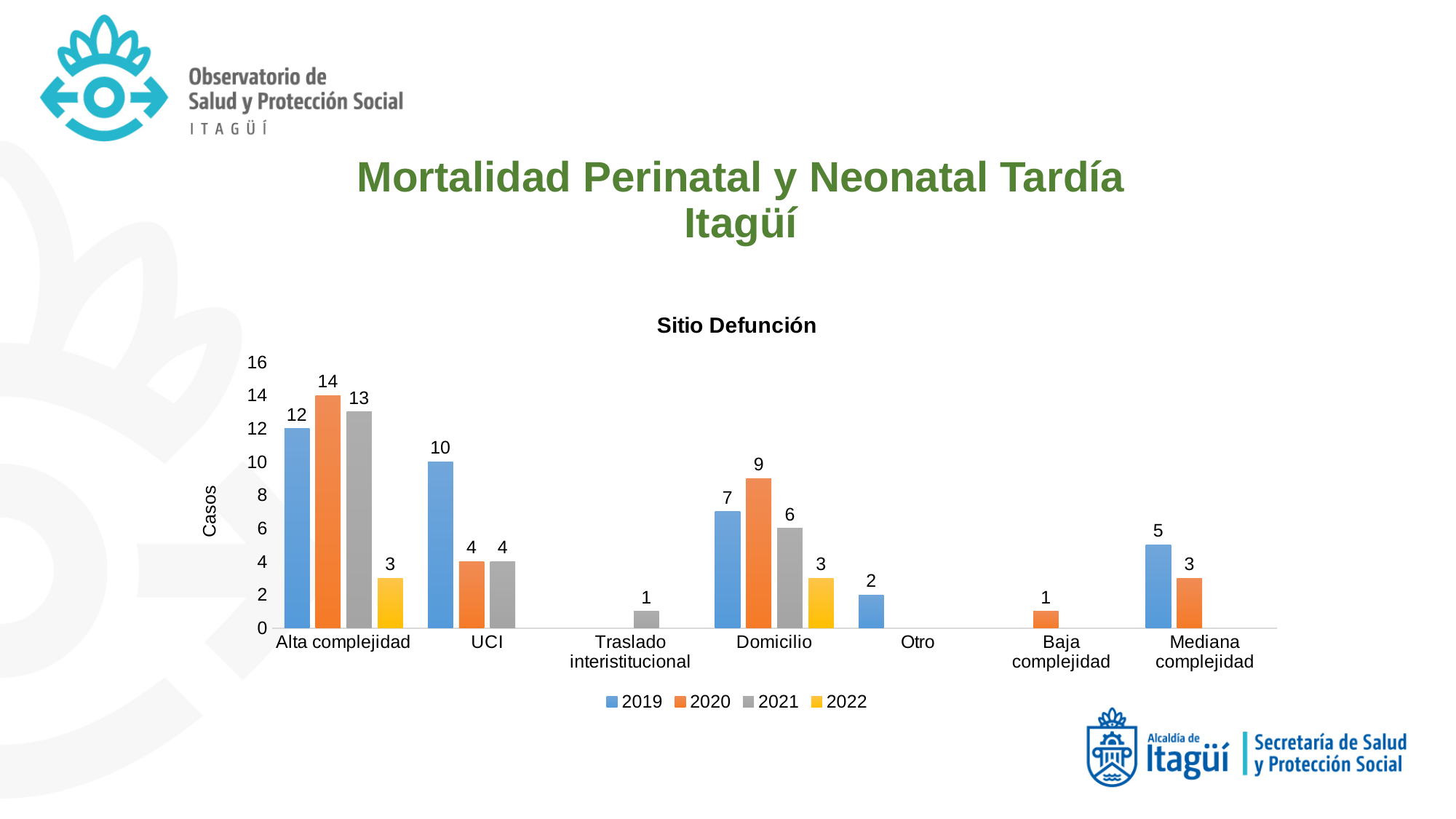
What kind of chart is shown on the slide? Bar chart What is the value for 2019 in the UCI category? 10 What is the title of the chart? Sitio Defunción How many series does the legend list? 4 Which category has the highest value for the 2021 series? Alta complejidad What is the value for 2022 in the Domicilio category? 3 What is the label of the vertical axis? Casos Which category has the lowest value for the 2020 series? Baja complejidad How many categories are shown on the x axis? 7 Which is larger in the Mediana complejidad category, the 2019 value or the 2020 value? 2019 What is the difference between the 2020 and 2019 values in the Domicilio category? 2 What is the value for 2020 in the Alta complejidad category? 14